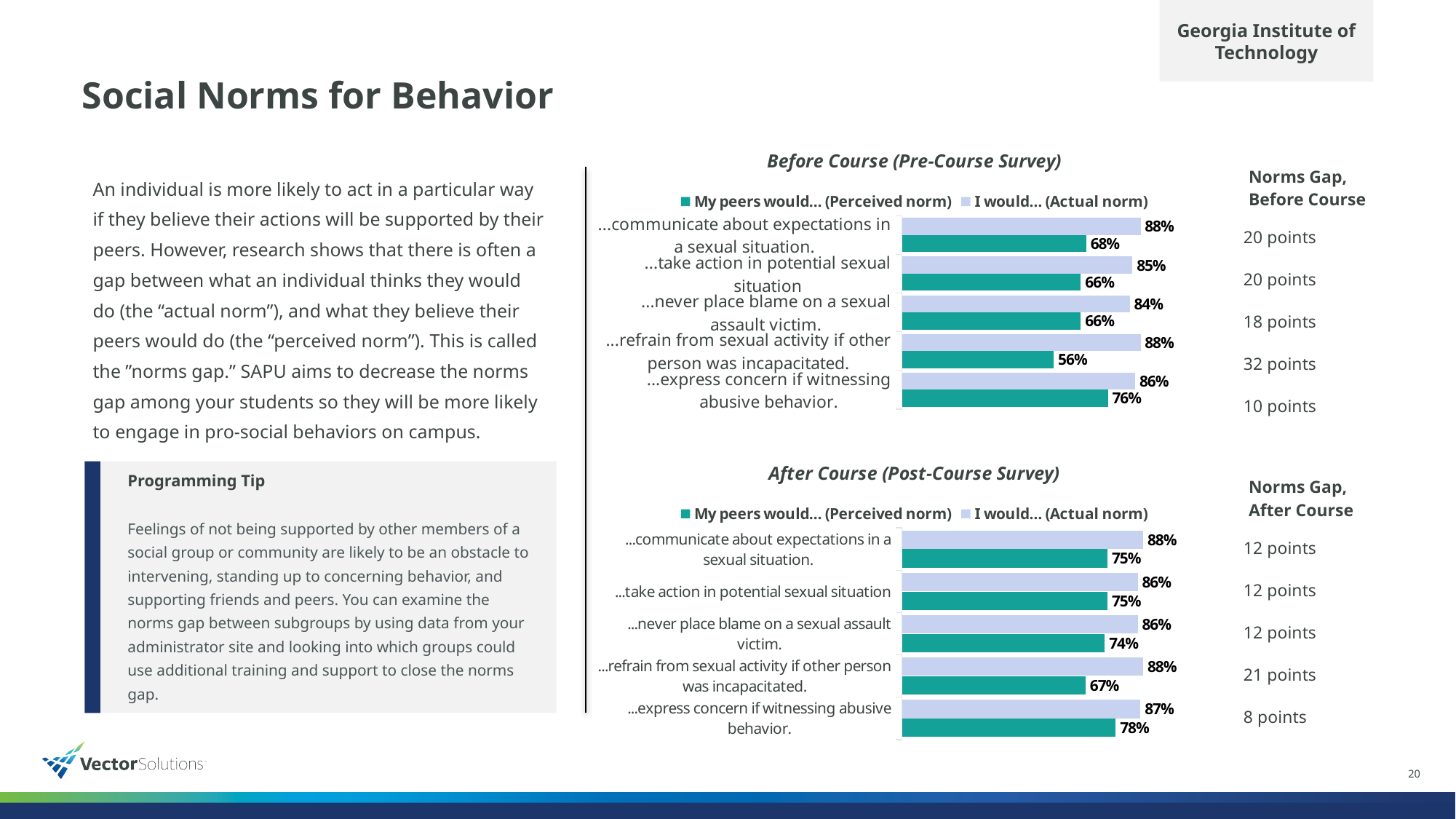
In the After Course (Post-Course Survey) chart, which category has the highest "My peers would... (Perceived norm)" value? ...express concern if witnessing abusive behavior. How many series does the legend of the After Course (Post-Course Survey) chart list? 2 In the After Course (Post-Course Survey) chart, which is larger for "...take action in potential sexual situation": "My peers would... (Perceived norm)" or "I would... (Actual norm)"? I would... (Actual norm) In the After Course (Post-Course Survey) chart, what is the difference between the "I would... (Actual norm)" and "My peers would... (Perceived norm)" values for "...communicate about expectations in a sexual situation"? 13 points In the Before Course (Pre-Course Survey) chart, what is the value for "I would... (Actual norm)" for "...refrain from sexual activity if other person was incapacitated"? 88% How many categories are shown in the Before Course (Pre-Course Survey) chart? 5 In the After Course (Post-Course Survey) chart, what is the value for "I would... (Actual norm)" for "...express concern if witnessing abusive behavior"? 87% What kind of chart is the Before Course (Pre-Course Survey) chart? Bar chart In the Before Course (Pre-Course Survey) chart, what is the value for "My peers would... (Perceived norm)" for "...express concern if witnessing abusive behavior"? 76% In the Before Course (Pre-Course Survey) chart, what is the difference between the "I would... (Actual norm)" and "My peers would... (Perceived norm)" values for "...refrain from sexual activity if other person was incapacitated"? 32 points In the Before Course (Pre-Course Survey) chart, which category has the lowest "My peers would... (Perceived norm)" value? ...refrain from sexual activity if other person was incapacitated. In the After Course (Post-Course Survey) chart, what is the value for "My peers would... (Perceived norm)" for "...never place blame on a sexual assault victim"? 74%